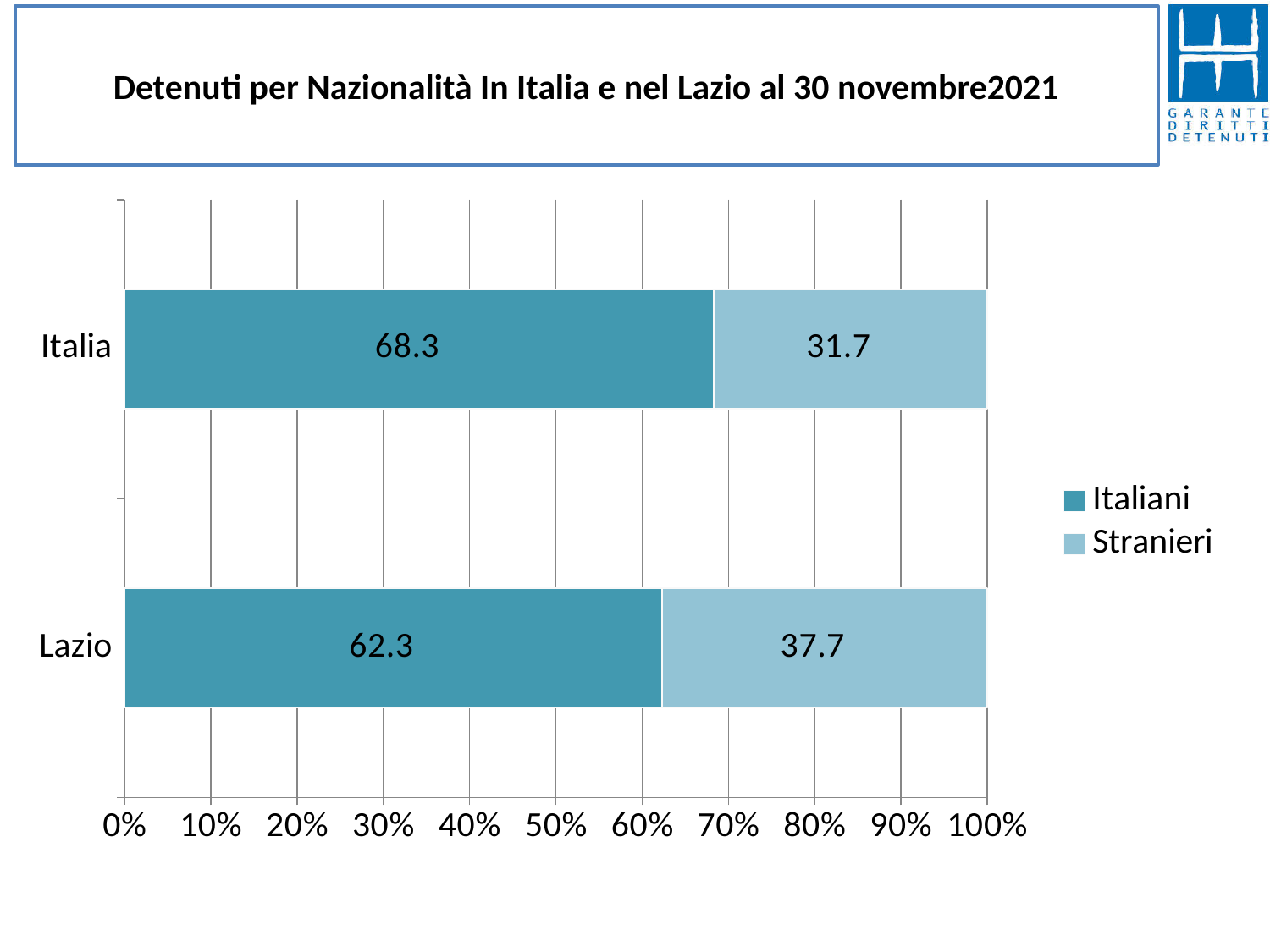
What is the difference between the Stranieri and Italiani values for Lazio? 24.6 What is the value for Stranieri in Italia? 31.7 Which category has the higher value for Italiani, Italia or Lazio? Italia What is the title of the chart? Detenuti per Nazionalità In Italia e nel Lazio al 30 novembre2021 What kind of chart is shown on the slide? Stacked bar chart How many series does the legend list? 2 What is the value for Italiani in Italia? 68.3 What is the value for Stranieri in Lazio? 37.7 Which category has the higher value for Stranieri, Italia or Lazio? Lazio What is the difference between the Italiani values for Italia and Lazio? 6 What is the value for Italiani in Lazio? 62.3 How many categories are shown on the chart? 2